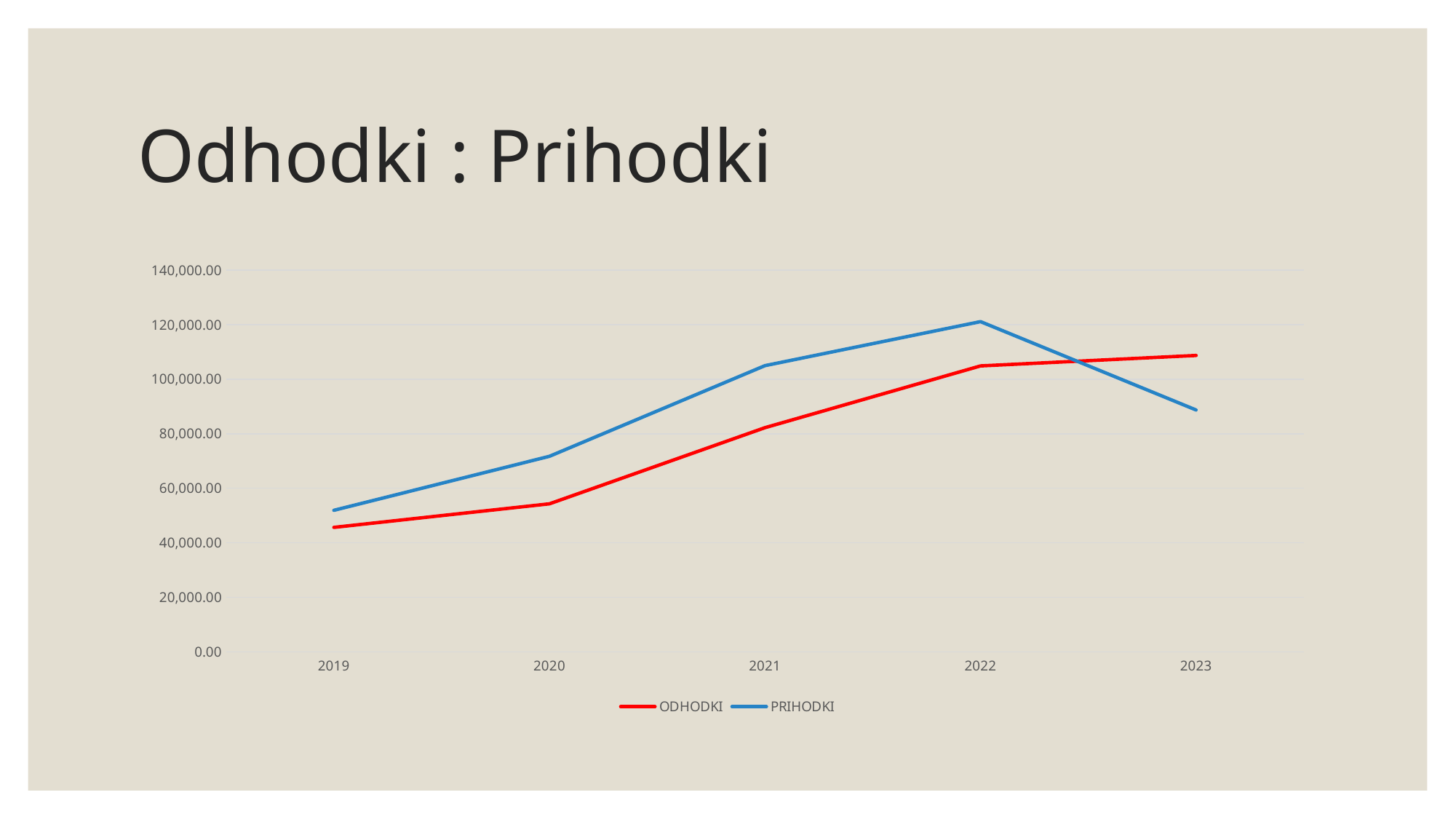
In 2021, which series has the larger value, ODHODKI or PRIHODKI? PRIHODKI In 2023, which series has the larger value, ODHODKI or PRIHODKI? ODHODKI Which year has the highest value for PRIHODKI? 2022 Is the value for ODHODKI in 2019 greater or less than 60,000.00? less What kind of chart is shown on the slide? line chart What colour is the ODHODKI line? red Which year has the lowest value for PRIHODKI? 2019 Does the PRIHODKI line rise or fall between 2022 and 2023? fall Which year has the lowest value for ODHODKI? 2019 Is the value for PRIHODKI in 2022 greater or less than 100,000.00? greater How many series does the legend list? 2 How many years are plotted along the x axis? 5